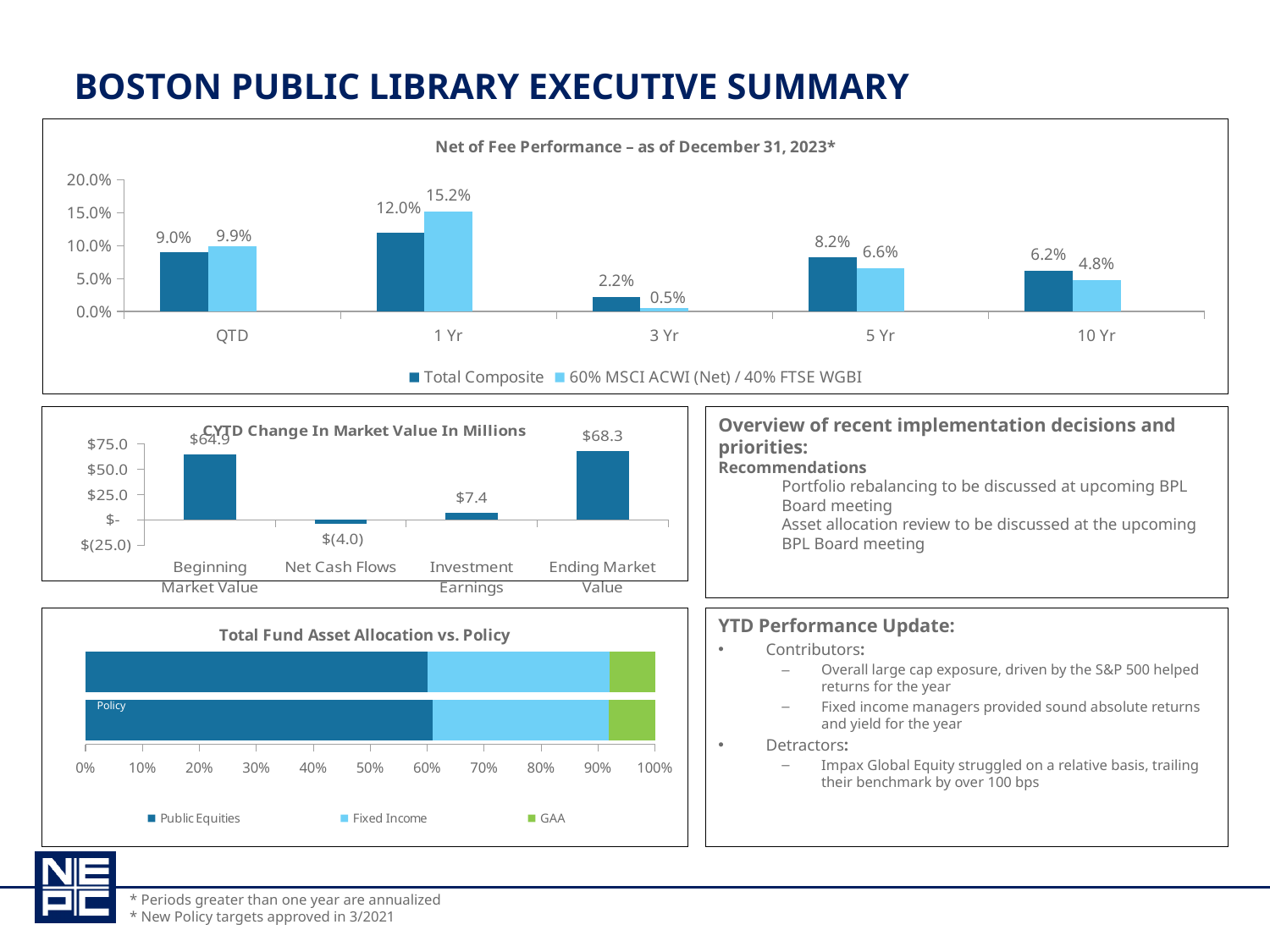
In the CYTD Change In Market Value In Millions chart, what is the value for Ending Market Value? $68.3 How many series does the legend of the Net of Fee Performance chart list? 2 What kind of chart is the Total Fund Asset Allocation vs. Policy chart? Stacked bar chart In the CYTD Change In Market Value In Millions chart, what is the value for Net Cash Flows? $(4.0) In the CYTD Change In Market Value In Millions chart, which category has the lowest value? Net Cash Flows How many periods are shown on the x axis of the Net of Fee Performance chart? 5 In the Total Fund Asset Allocation vs. Policy chart, is the Public Equities share of the Policy bar greater or less than 50%? greater In the Net of Fee Performance chart, what is the 3 Yr value for 60% MSCI ACWI (Net) / 40% FTSE WGBI? 0.5% In the Net of Fee Performance chart, what is the difference between the 1 Yr values for 60% MSCI ACWI (Net) / 40% FTSE WGBI and Total Composite? 3.2% In the Net of Fee Performance chart, what is the 1 Yr value for Total Composite? 12.0% In the Net of Fee Performance chart, which is larger for 5 Yr: Total Composite or 60% MSCI ACWI (Net) / 40% FTSE WGBI? Total Composite In the Net of Fee Performance chart, which period has the highest Total Composite value? 1 Yr